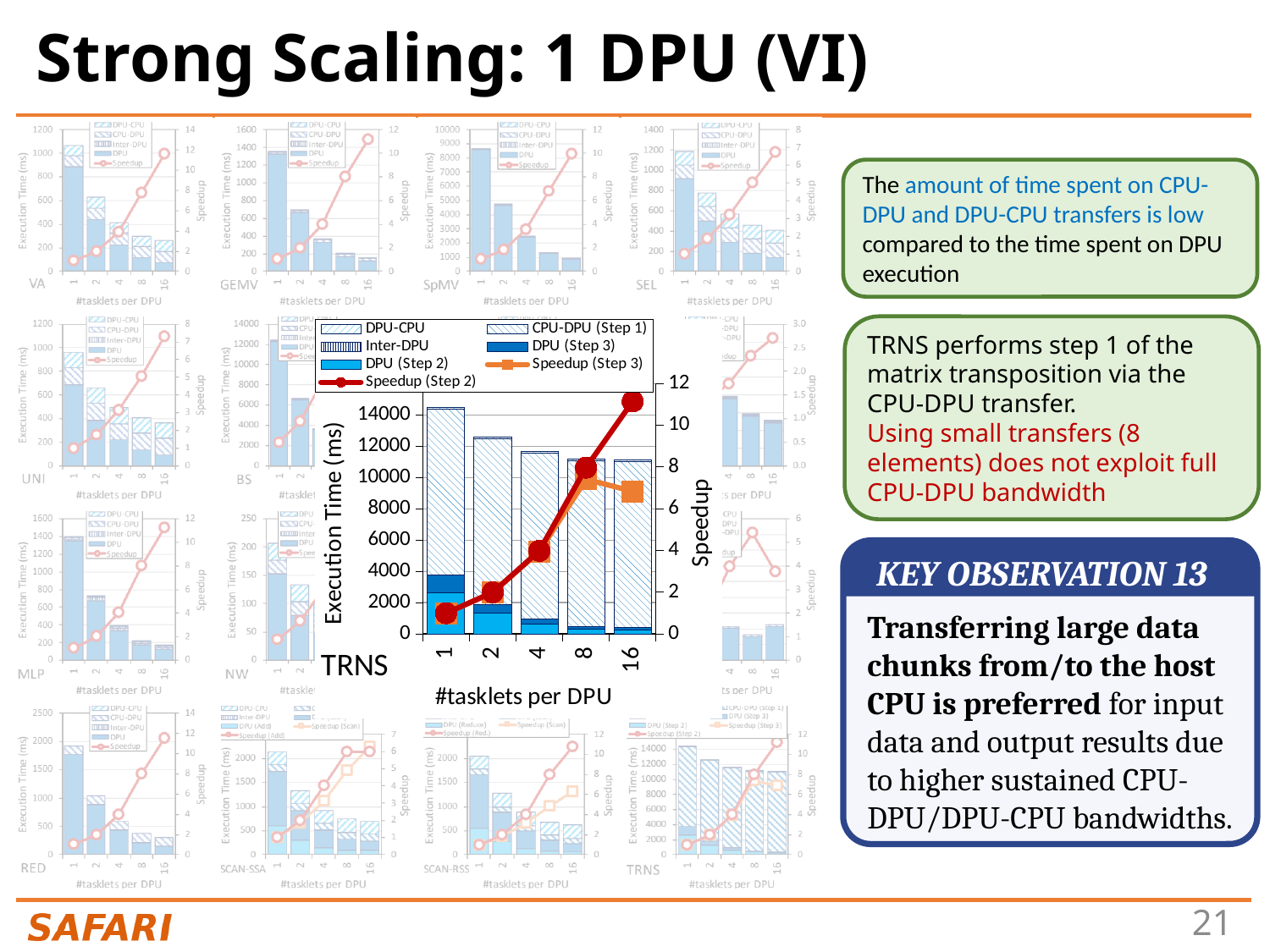
In the enlarged TRNS chart, is Speedup (Step 3) at 16 tasklets per DPU greater or less than 8? less In the enlarged TRNS chart, at 16 tasklets per DPU, which is larger: Speedup (Step 2) or Speedup (Step 3)? Speedup (Step 2) In the enlarged TRNS chart, what kind of chart is used for the execution time series? Stacked bar chart In the enlarged TRNS chart, does Speedup (Step 2) rise or fall as the number of tasklets per DPU increases? Rise In the enlarged TRNS chart, does the total execution time rise or fall as the number of tasklets per DPU increases? Fall In the enlarged TRNS chart, how many values does the x axis (#tasklets per DPU) show? 5 In the enlarged TRNS chart, at which number of tasklets per DPU is Speedup (Step 2) highest? 16 In the enlarged TRNS chart, how many series does the legend list? 7 In the enlarged TRNS chart, is the total execution time at 2 tasklets per DPU greater or less than 12000 ms? greater In the enlarged TRNS chart, what is the label of the right-hand y axis? Speedup In the enlarged TRNS chart, is Speedup (Step 2) at 16 tasklets per DPU greater or less than 10? greater In the enlarged TRNS chart, at which number of tasklets per DPU is the total execution time highest? 1